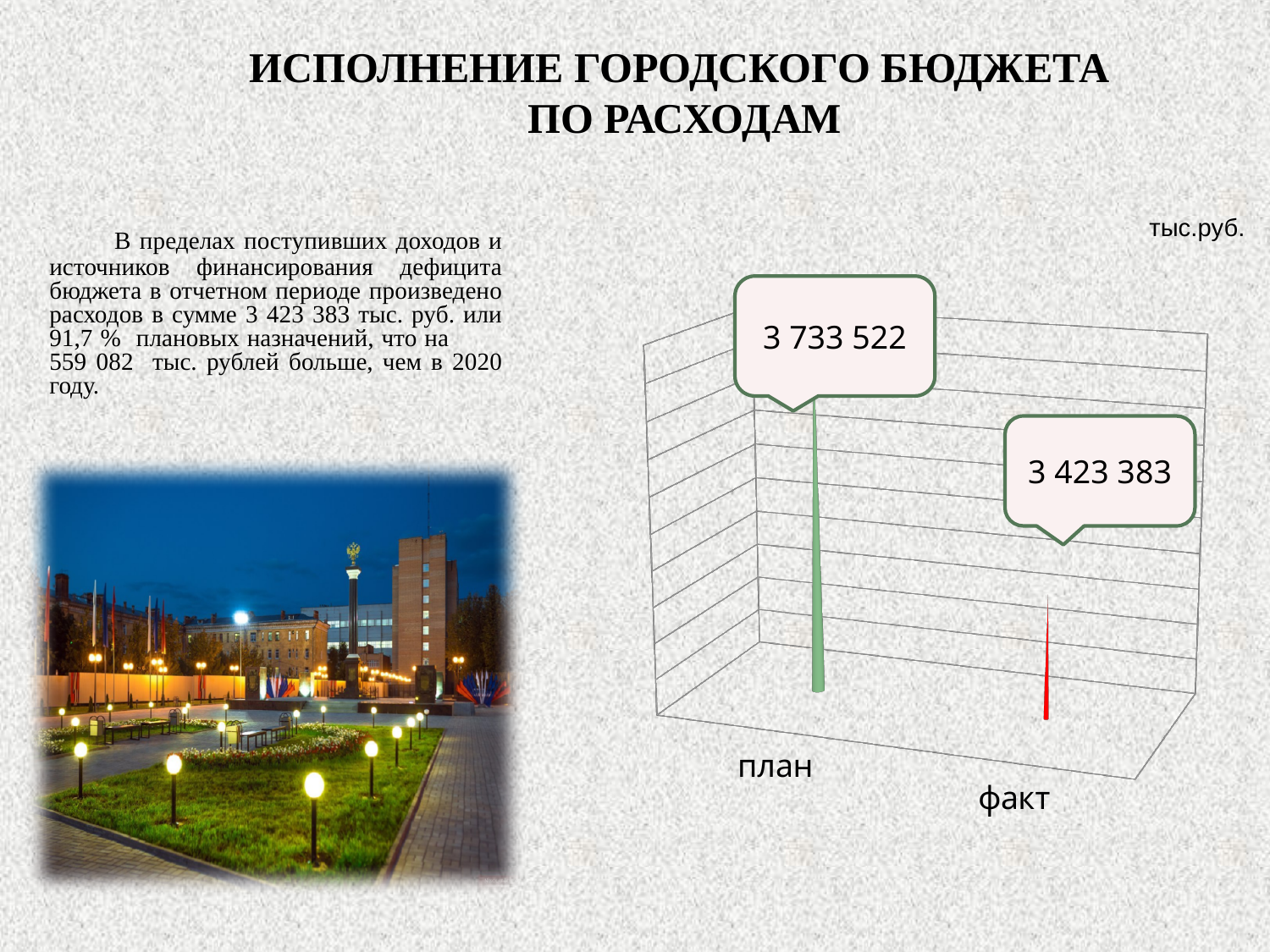
What is the value for факт on the chart? 3 423 383 Is the value for факт larger or smaller than the value for план? smaller What colour is the bar for факт? red How many categories are plotted on the chart? 2 What is the difference between the план and факт values? 310 139 What unit is indicated for the chart values? тыс.руб. What is the value for план on the chart? 3 733 522 Which category has the lowest value on the chart? факт Which category has the higher value, план or факт? план What kind of chart is shown on the slide? bar chart